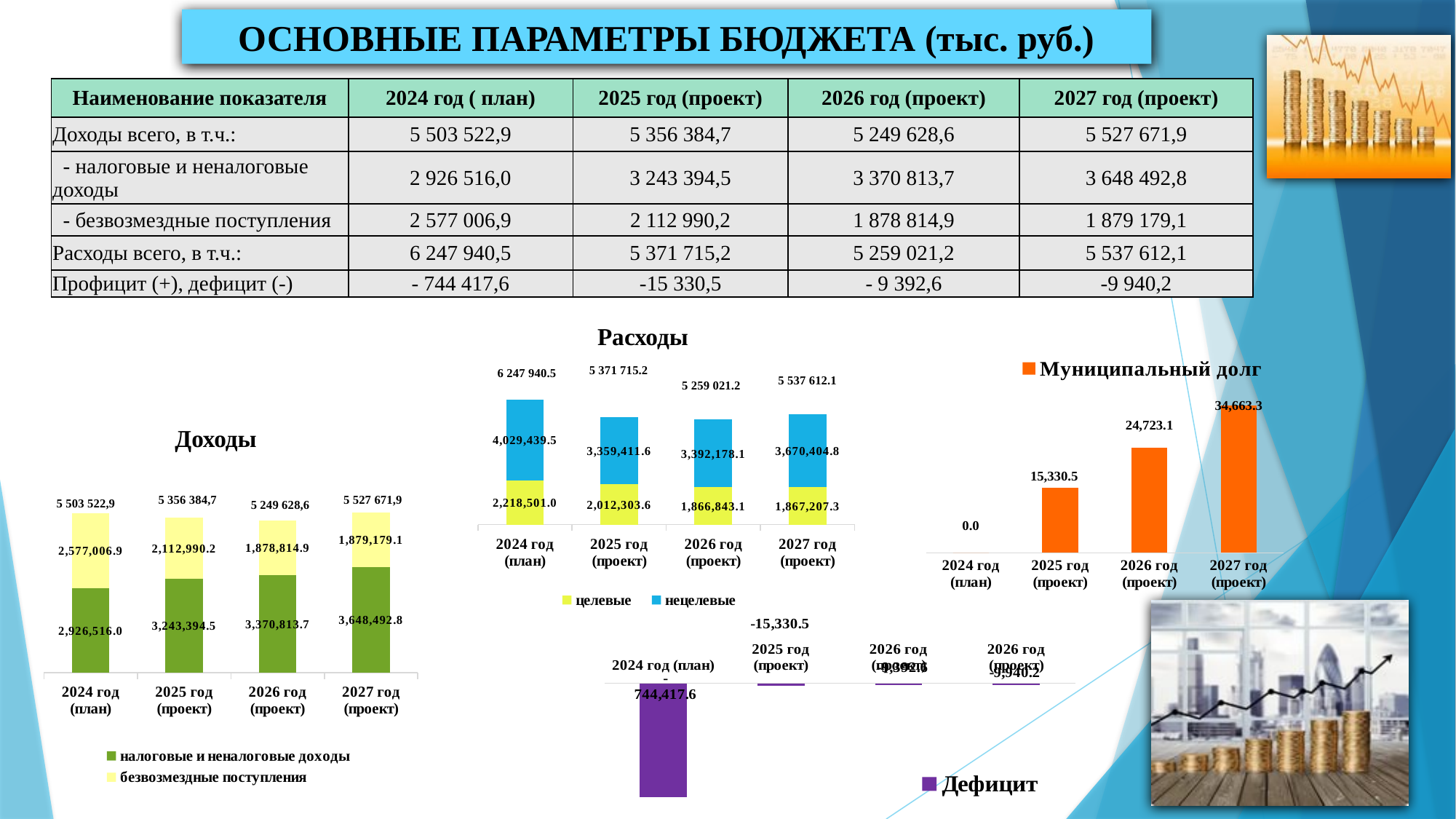
In the 'Доходы' chart, what is the value of 'налоговые и неналоговые доходы' for 2027 год (проект)? 3,648,492.8 In the 'Расходы' chart, what is the value of 'нецелевые' for 2026 год (проект)? 3,392,178.1 In the 'Доходы' chart, which year has the highest value of 'безвозмездные поступления'? 2024 год (план) In the 'Расходы' chart, what is the difference between the 'целевые' values for 2024 год (план) and 2025 год (проект)? 206,197.4 In the 'Расходы' chart, what kind of chart is shown? Stacked bar chart In the 'Доходы' chart, what is the total of the stacked bar for 2024 год (план)? 5 503 522,9 In the 'Доходы' chart, how many series does the legend list? 2 In the 'Дефицит' chart, what is the value for 2024 год (план)? -744,417.6 In the 'Расходы' chart, which year has the lowest value of 'целевые'? 2026 год (проект) In the 'Муниципальный долг' chart, do the values rise or fall from 2024 to 2027? Rise In the 'Муниципальный долг' chart, how many categories are shown on the x axis? 4 In the 'Муниципальный долг' chart, what is the value for 2026 год (проект)? 24,723.1